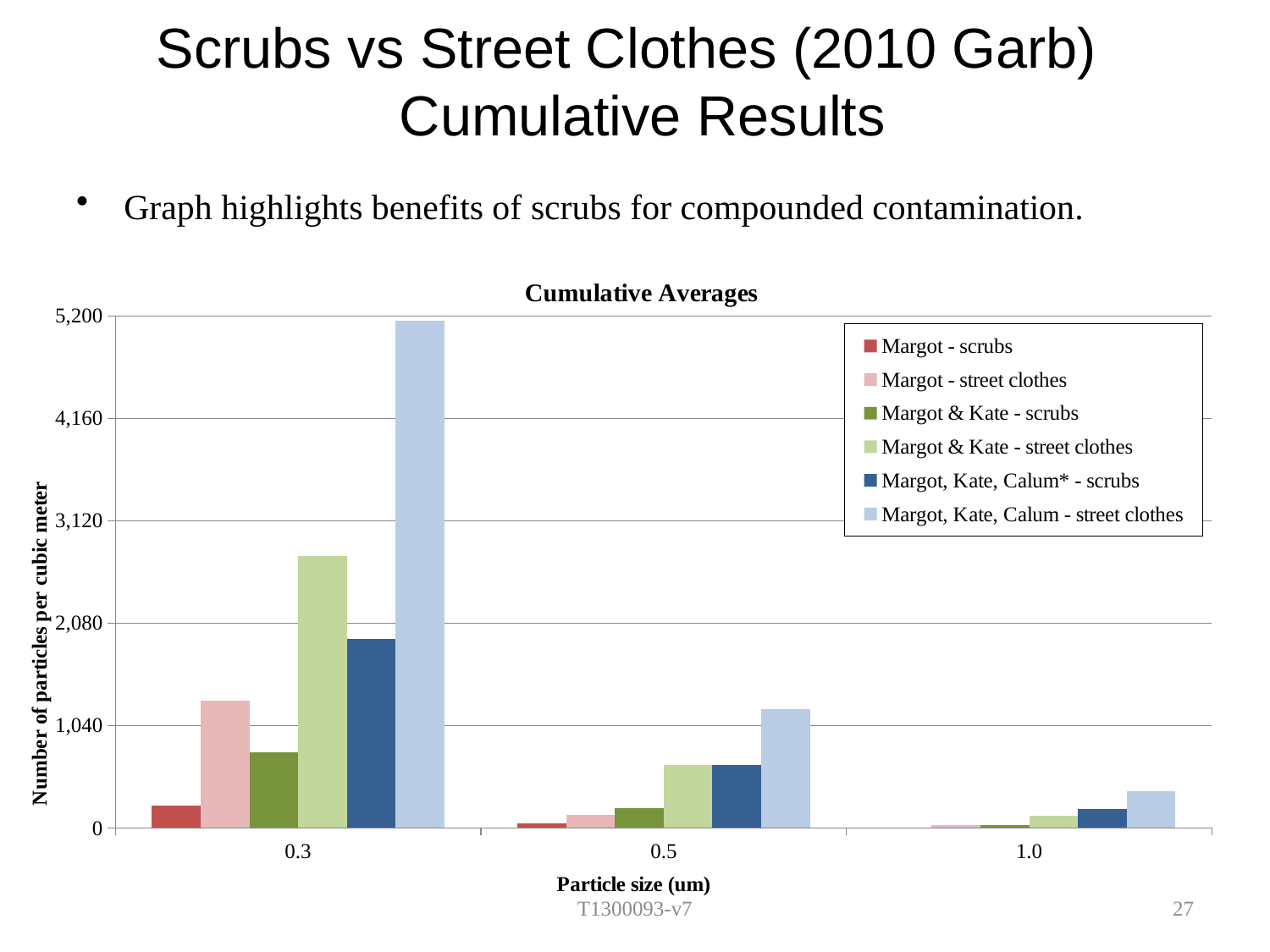
Which series has the highest value at particle size 0.3? Margot, Kate, Calum - street clothes Do the values for Margot, Kate, Calum - street clothes rise or fall as particle size increases from 0.3 to 1.0? Fall Is the value for Margot, Kate, Calum - street clothes at particle size 0.3 greater or less than 4,160? greater How many series does the legend list? 6 What is the title of the chart? Cumulative Averages How many particle size categories are shown on the x axis? 3 Is the value for Margot & Kate - street clothes at particle size 0.3 greater or less than 3,120? less At particle size 0.3, which is larger: Margot - scrubs or Margot - street clothes? Margot - street clothes Is the value for Margot, Kate, Calum - street clothes at particle size 0.5 greater or less than 1,040? greater Which series has the lowest value at particle size 0.3? Margot - scrubs What kind of chart is shown on the slide? Bar chart What is the label of the y axis? Number of particles per cubic meter